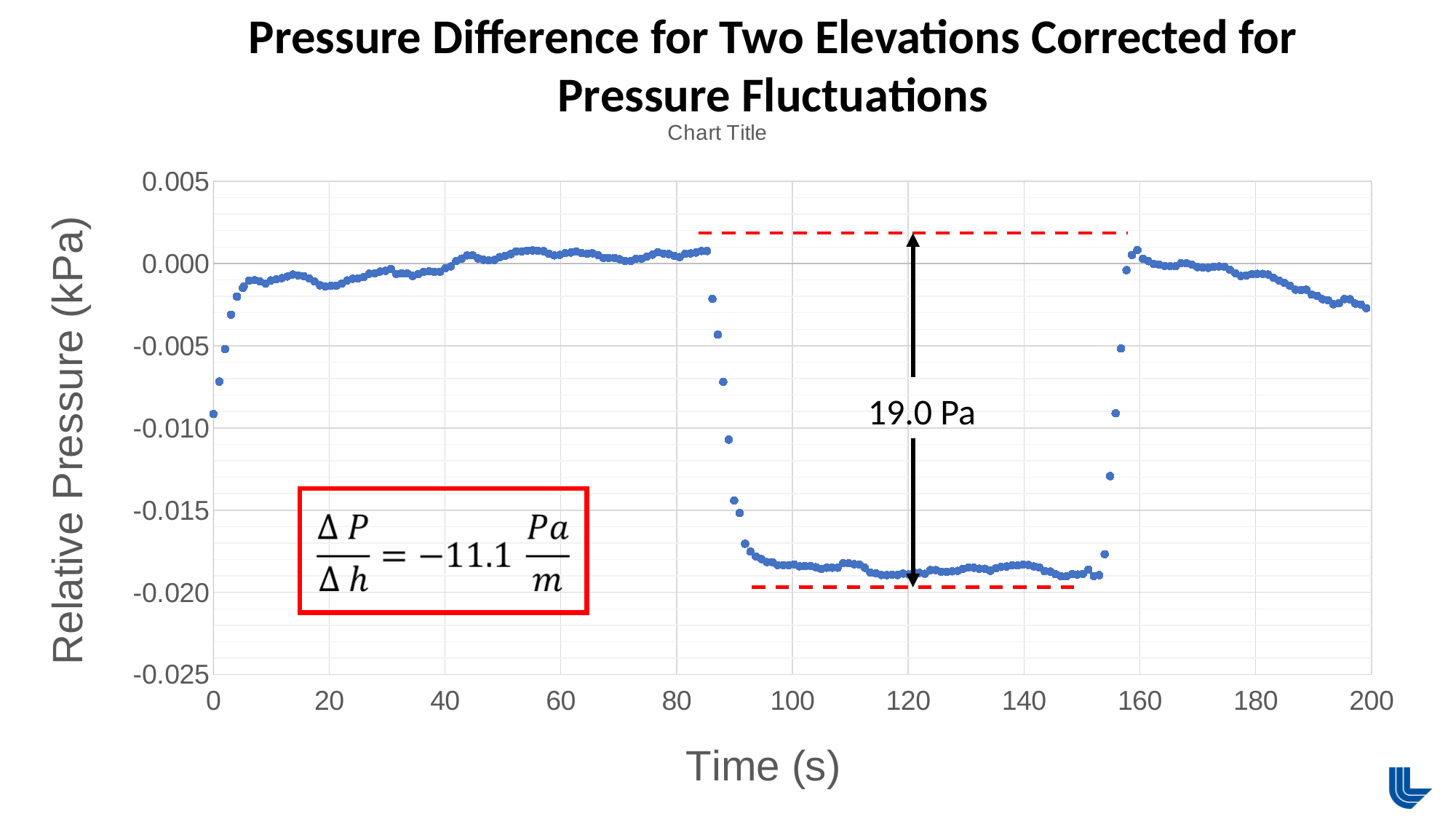
Is the relative pressure at a time of 180 s greater or less than -0.010 kPa? greater What is the label of the vertical axis of the chart? Relative Pressure (kPa) What is the label of the horizontal axis of the chart? Time (s) What is the highest tick value shown on the vertical axis? 0.005 Is the relative pressure at a time of 100 s greater or less than -0.010 kPa? less What pressure difference is annotated between the two dashed red lines on the chart? 19.0 Pa Is the relative pressure at a time of 40 s greater or less than -0.005 kPa? greater Which has the larger relative pressure: the point at 60 s or the point at 120 s? 60 s Do the relative pressure values rise or fall between 150 s and 160 s? rise What kind of chart is shown on the slide? scatter chart Do the relative pressure values rise or fall between 80 s and 100 s? fall